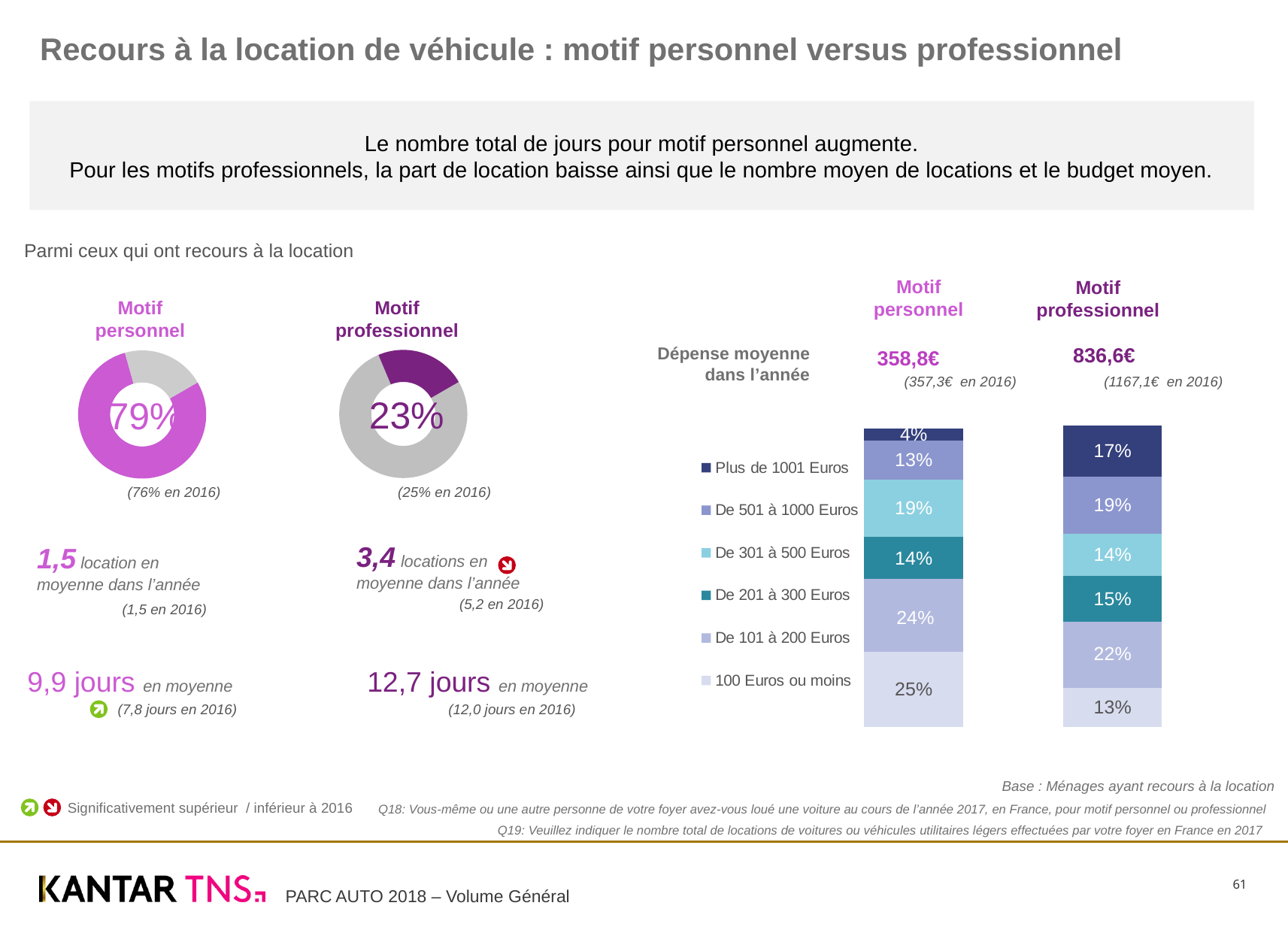
In the stacked bar chart on the right, which segment is the smallest in the Motif personnel bar? Plus de 1001 Euros In the 'Motif professionnel' donut chart, what percentage is shown in the centre? 23% What kind of chart is used on the right of the slide to show the spending breakdown? Stacked bar chart In the stacked bar chart on the right, what is the difference between the 'Plus de 1001 Euros' values for Motif professionnel and Motif personnel? 13% In the stacked bar chart on the right, what is the value of the '100 Euros ou moins' segment for Motif professionnel? 13% In the stacked bar chart on the right, which segment is the largest in the Motif personnel bar? 100 Euros ou moins In the 'Motif personnel' donut chart, what percentage is shown in the centre? 79% In the stacked bar chart on the right, which is larger for 'De 201 à 300 Euros': Motif personnel or Motif professionnel? Motif professionnel In the stacked bar chart on the right, what is the value of the 'Plus de 1001 Euros' segment for Motif professionnel? 17% In the stacked bar chart on the right, what is the value of the 'De 101 à 200 Euros' segment for Motif personnel? 24% How many series does the legend of the stacked bar chart on the right list? 6 In the stacked bar chart on the right, what is the total of the Motif professionnel bar? 100%